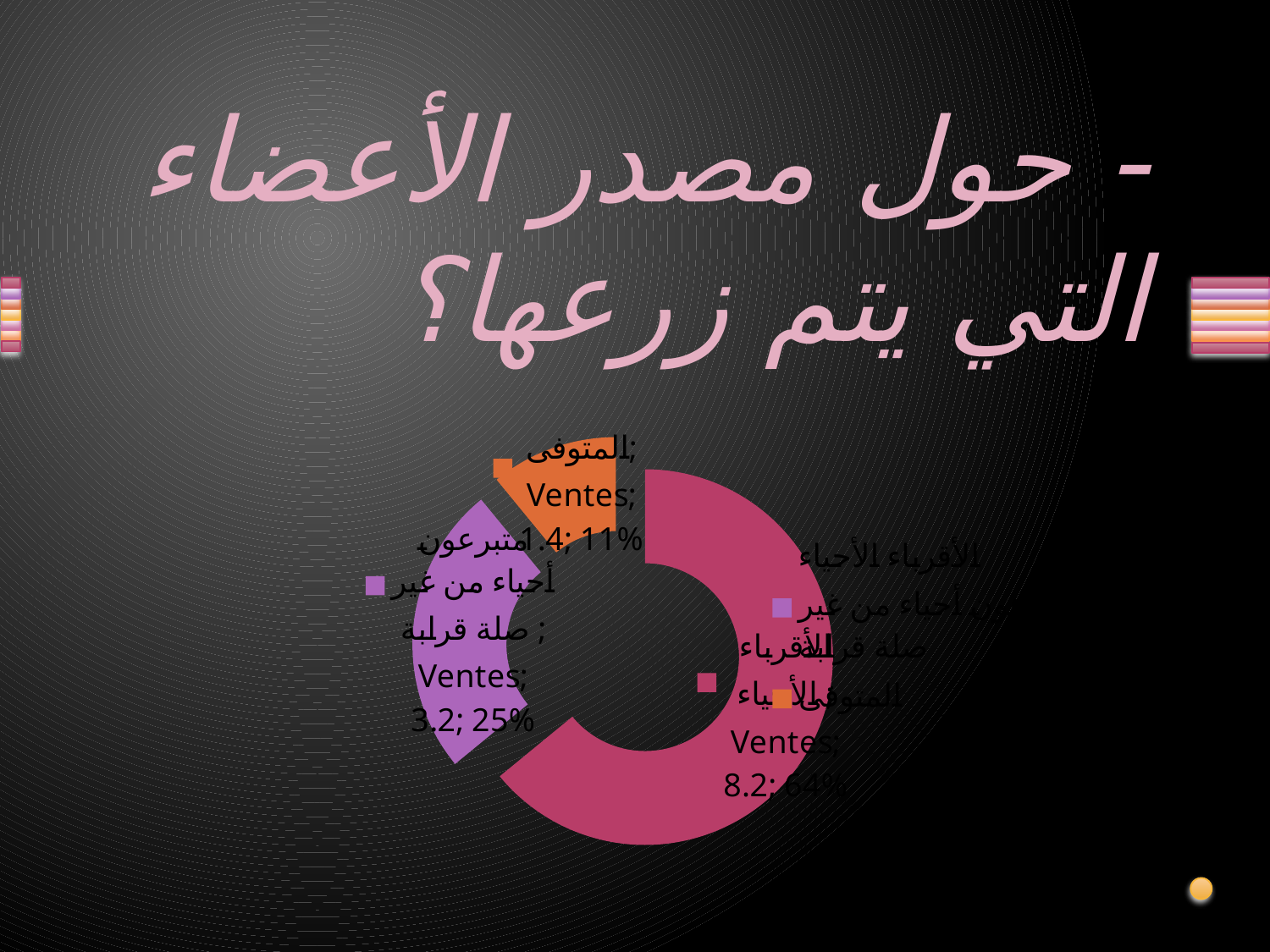
What kind of chart is shown on the slide? Doughnut chart What series name appears in the data labels of the chart? Ventes Which slice has the smallest share of the doughnut chart? المتوفى Which slice has the largest share of the doughnut chart? الأقرباء الأحياء What percentage share does the slice labelled المتوفى have? 11% How many slices does the doughnut chart have? 3 What is the value shown for the slice for متبرعون أحياء من غير صلة قرابة? 3.2 What is the value shown for the slice labelled الأقرباء الأحياء? 8.2 What is the value shown for the slice labelled المتوفى? 1.4 What percentage share does the slice for متبرعون أحياء من غير صلة قرابة have? 25% What percentage share does the slice labelled الأقرباء الأحياء have? 64% What is the difference in percentage points between the الأقرباء الأحياء slice and the المتوفى slice? 53